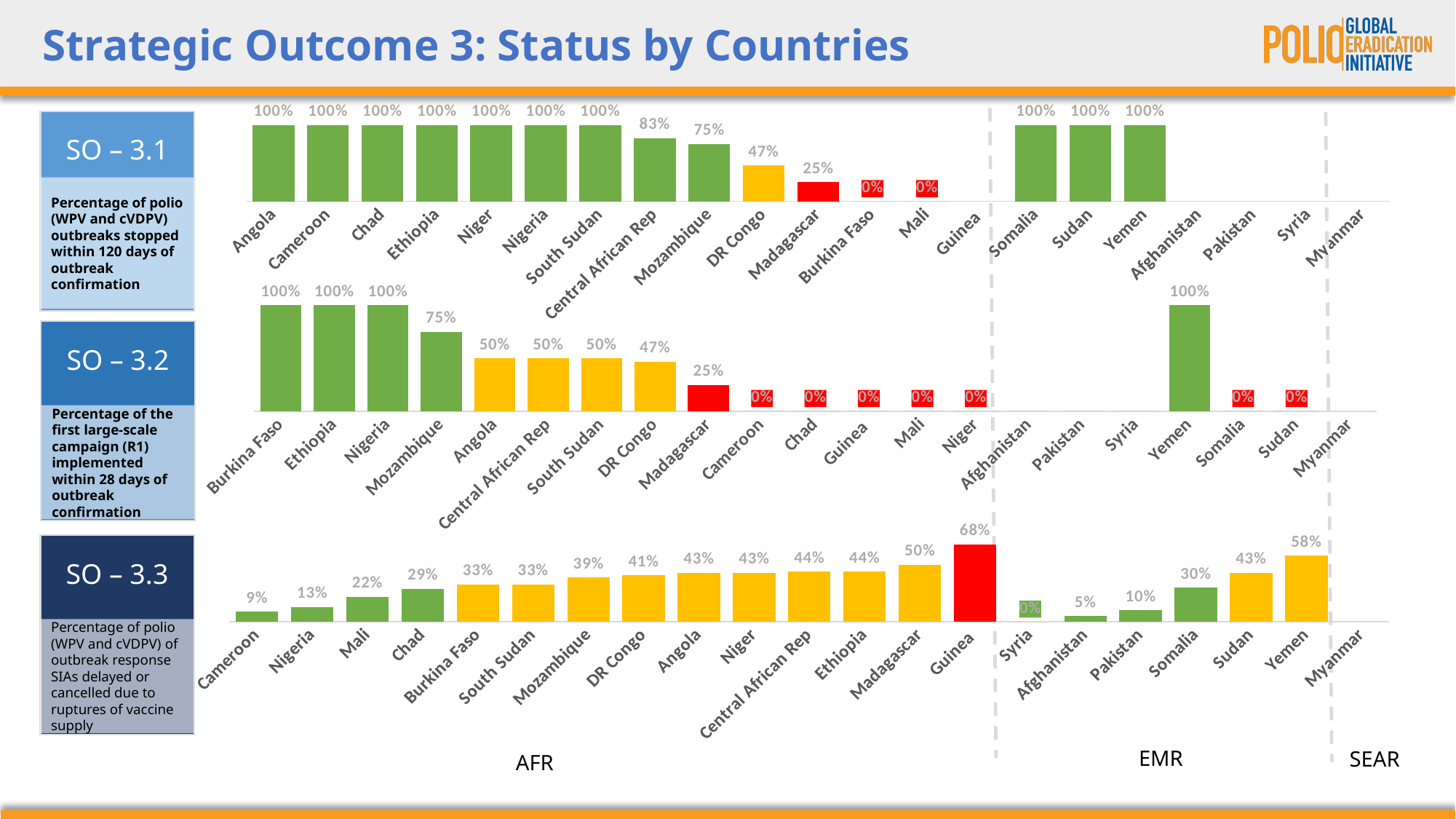
What kind of chart is the SO – 3.3 chart? Bar chart In the SO – 3.2 chart, what is the value for Mozambique? 75% In the SO – 3.3 chart, what is the value for Cameroon? 9% In the SO – 3.2 chart, which is larger, the value for DR Congo or the value for Angola? Angola In the SO – 3.1 chart, what is the difference between the values for Mozambique and Madagascar? 50% In the SO – 3.1 chart, what is the value for Central African Rep? 83% In the SO – 3.3 chart, which is larger, the value for Somalia or the value for Pakistan? Somalia In the SO – 3.2 chart, what is the value for Madagascar? 25% In the SO – 3.1 chart, what is the value for DR Congo? 47% In the SO – 3.3 chart, which country has the highest value? Guinea In the SO – 3.3 chart, what is the value for Yemen? 58% In the SO – 3.3 chart, what is the difference between the values for Guinea and Madagascar? 18%